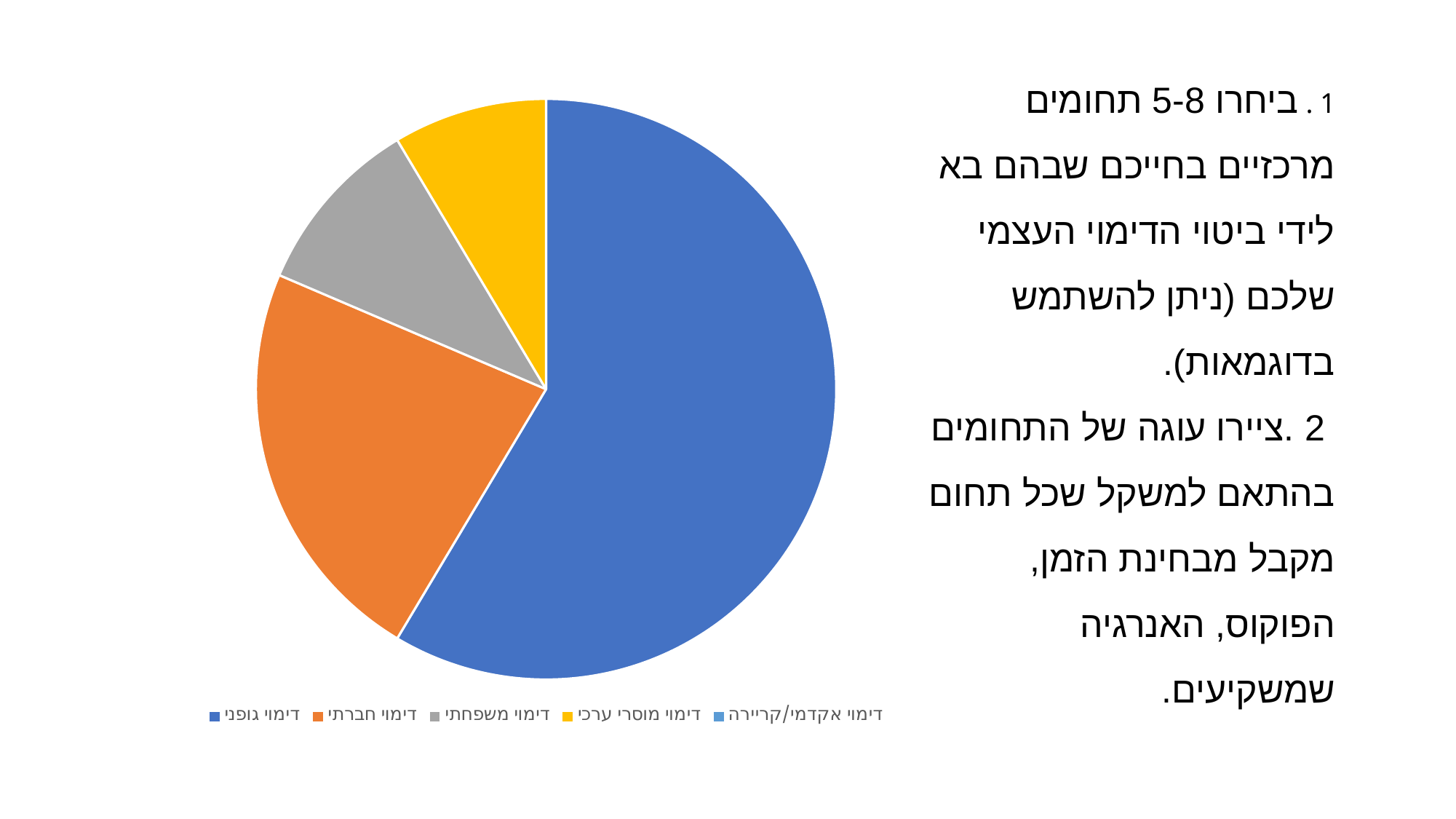
What colour is the slice for דימוי גופני? blue Which is larger, the slice for דימוי גופני or the slice for דימוי חברתי? דימוי גופני Which is larger, the slice for דימוי חברתי or the slice for דימוי מוסרי ערכי? דימוי חברתי Which is larger, the slice for דימוי חברתי or the slice for דימוי משפחתי? דימוי חברתי What kind of chart is shown on the slide? pie chart Is the slice for דימוי גופני greater or less than half of the pie? greater Which category has the largest slice of the pie? דימוי גופני Which category does the orange slice represent? דימוי חברתי How many entries does the legend of the pie chart list? 5